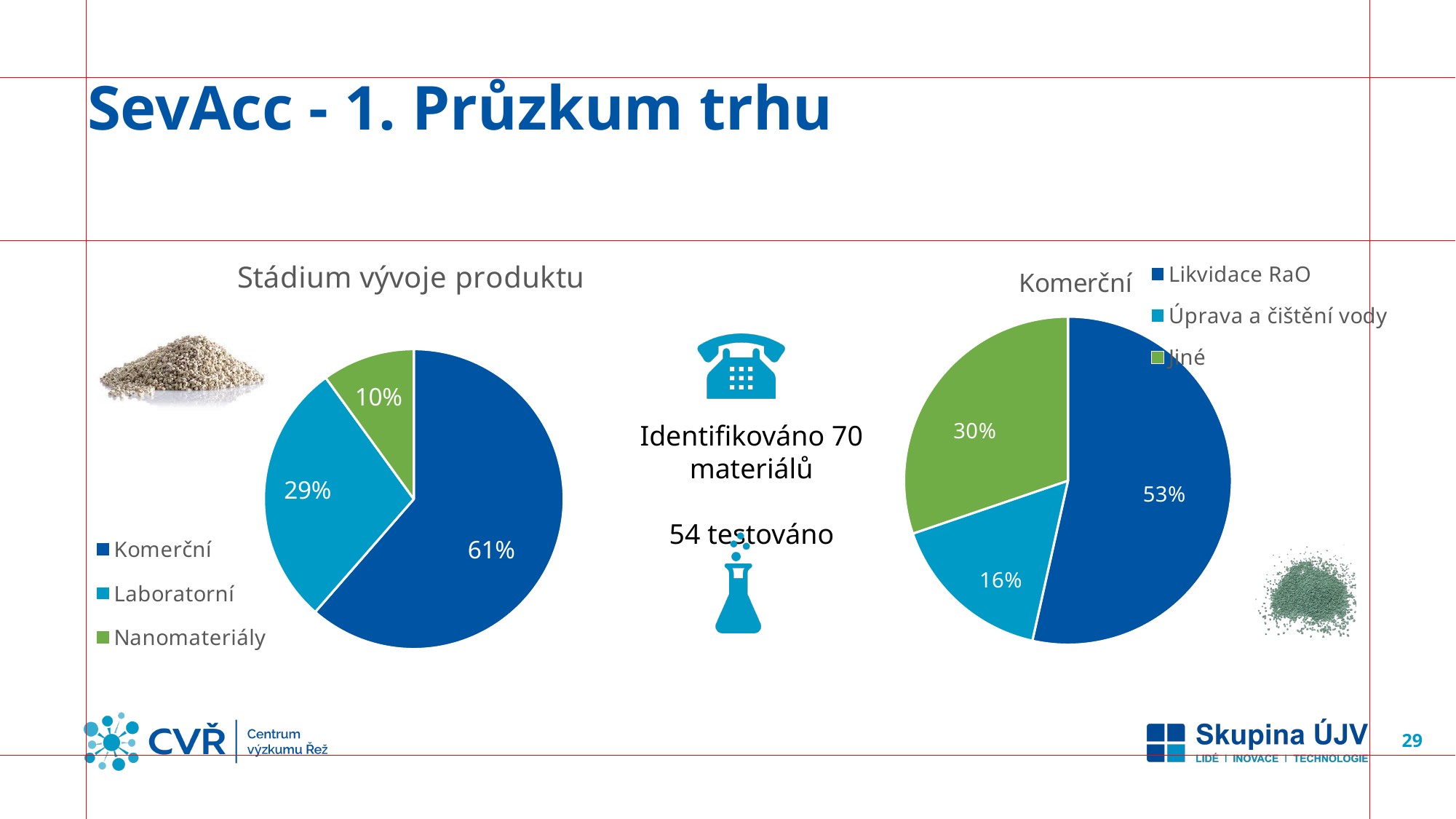
In the 'Komerční' chart, what share is Úprava a čištění vody? 16% What kind of chart is the 'Stádium vývoje produktu' chart? Pie chart In the 'Komerční' chart, what share is Likvidace RaO? 53% In the 'Stádium vývoje produktu' chart, which category has the smallest slice? Nanomateriály In the 'Stádium vývoje produktu' chart, what share is Komerční? 61% In the 'Stádium vývoje produktu' chart, what is the difference between the Komerční and Laboratorní shares? 32% In the 'Komerční' chart, what share is Jiné? 30% In the 'Stádium vývoje produktu' chart, how many categories does the legend list? 3 In the 'Komerční' chart, what is the difference between the Likvidace RaO and Jiné shares? 23% In the 'Komerční' chart, which category has the largest slice? Likvidace RaO In the 'Stádium vývoje produktu' chart, what share is Laboratorní? 29% In the 'Komerční' chart, which is larger: Jiné or Úprava a čištění vody? Jiné